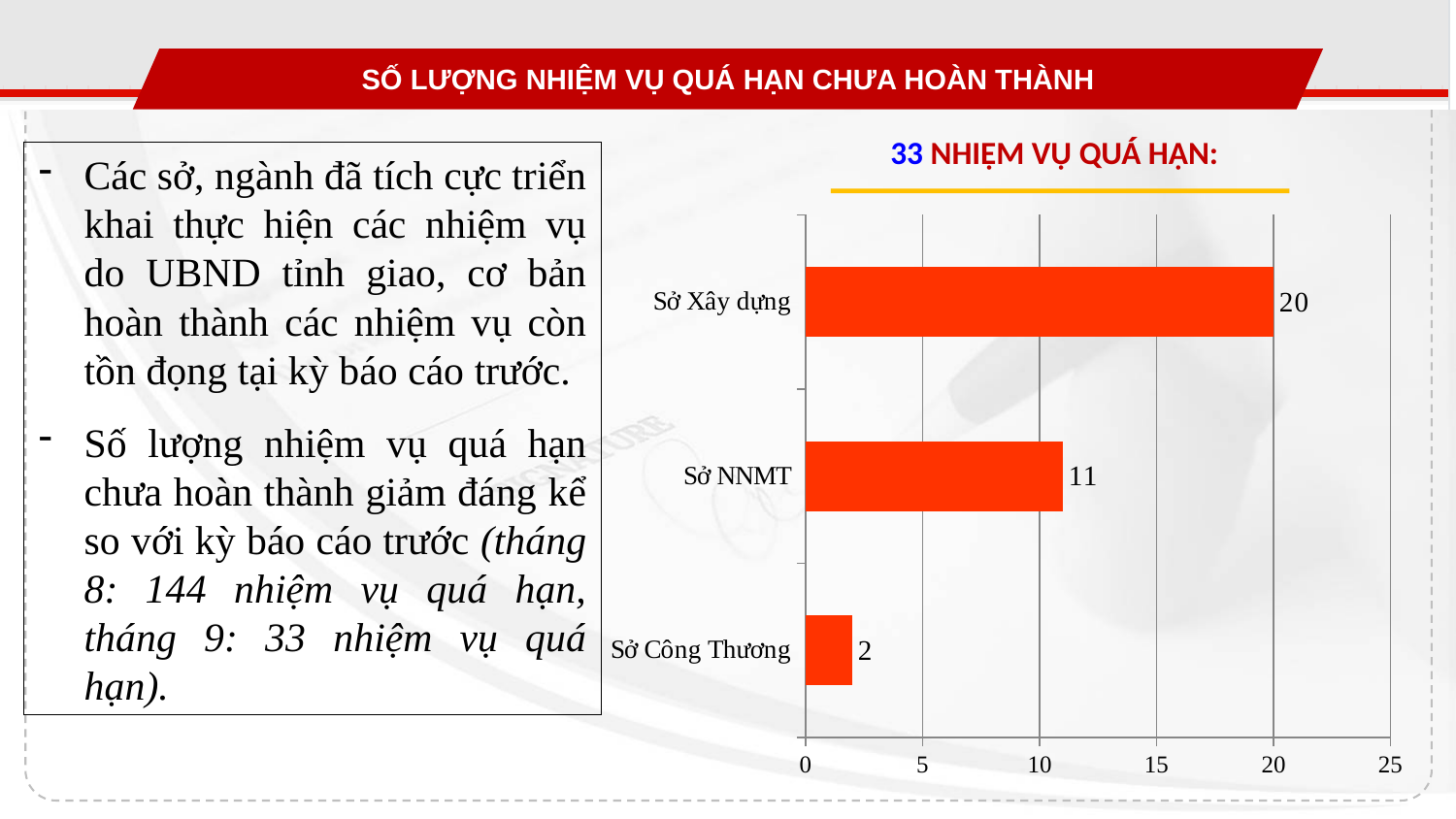
What is the value for Sở Xây dựng? 20 What kind of chart is shown on the slide? bar chart What is the difference between the values for Sở Xây dựng and Sở NNMT? 9 How many categories are shown in the chart? 3 Which category has the lowest value? Sở Công Thương What is the title of the chart? 33 NHIỆM VỤ QUÁ HẠN: What is the value for Sở Công Thương? 2 What is the value for Sở NNMT? 11 What is the difference between the values for Sở NNMT and Sở Công Thương? 9 Which is larger, the value for Sở NNMT or the value for Sở Công Thương? Sở NNMT Is the value for Sở NNMT greater or less than 15? less Which category has the highest value? Sở Xây dựng